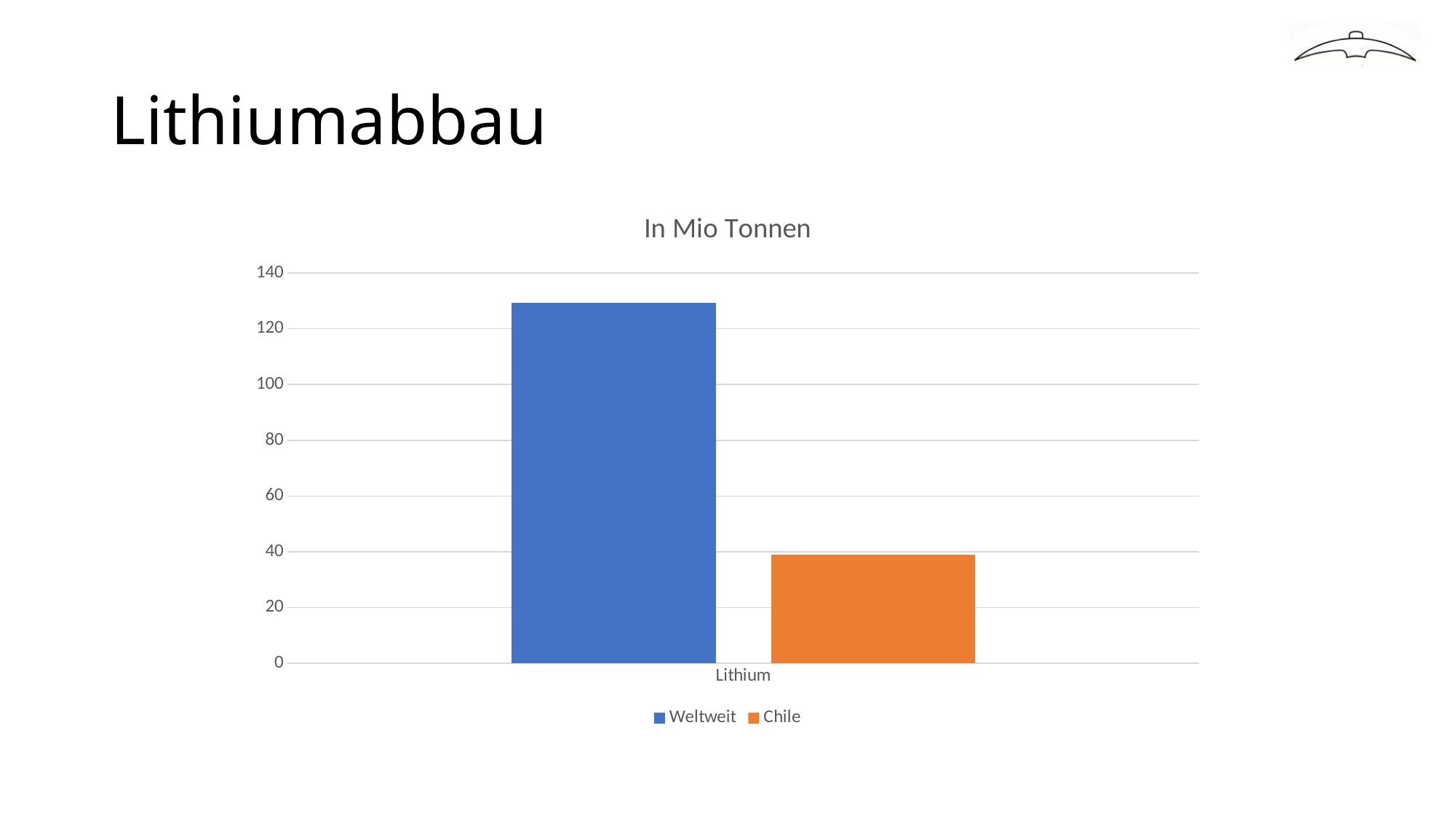
Is the value for Chile greater or less than 20? greater What is the title of the chart? In Mio Tonnen How many categories are shown on the x axis? 1 What kind of chart is shown on the slide? bar chart Which series has the higher value for Lithium, Weltweit or Chile? Weltweit Is the value for Weltweit greater or less than 120? greater Which series has the lowest value? Chile Which series are listed in the legend? Weltweit, Chile Is the value for Weltweit greater or less than 140? less How many series does the legend list? 2 What is the label of the category on the x axis? Lithium